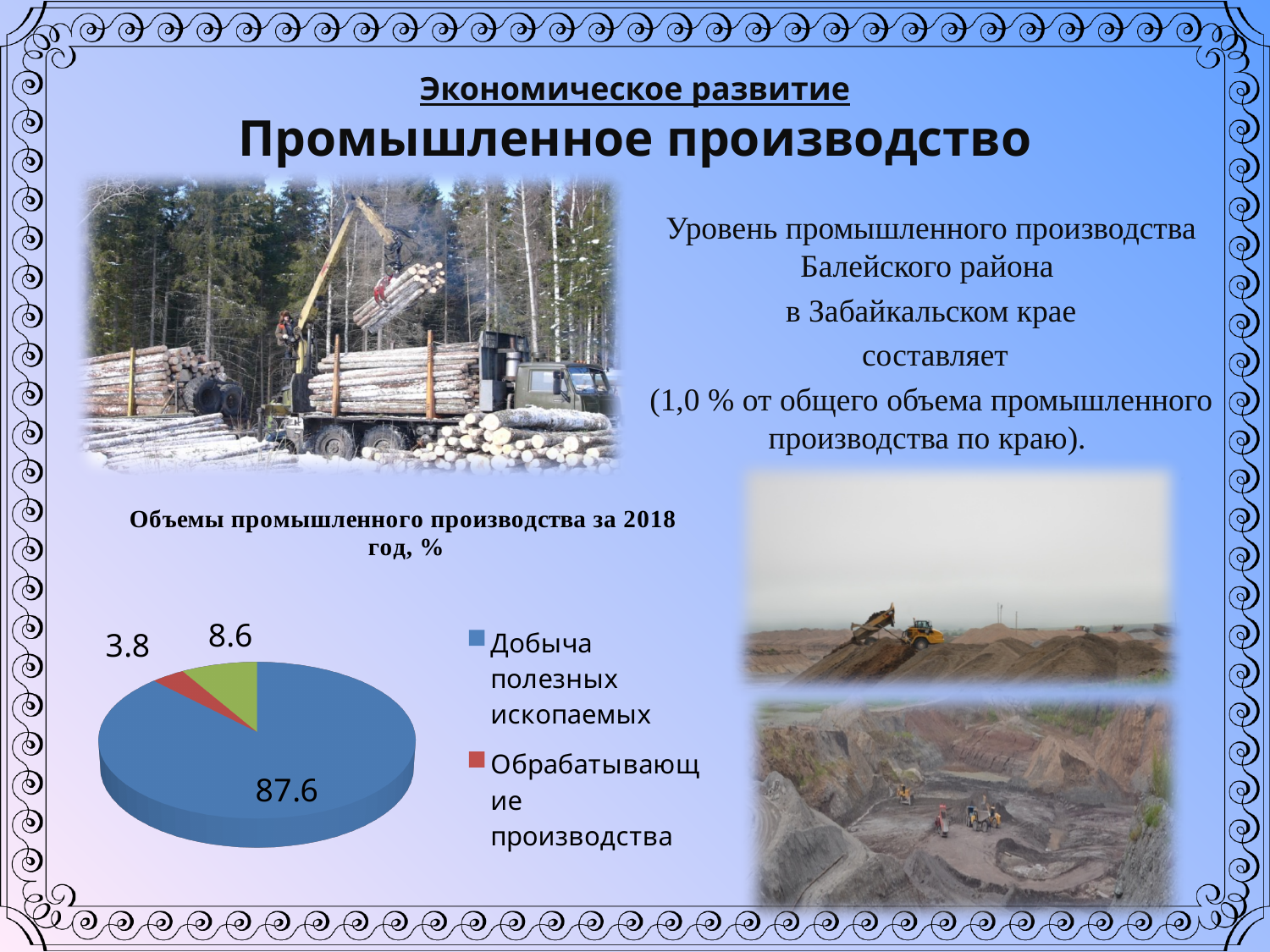
How many entries does the pie chart's legend list? 2 What kind of chart is shown on the slide? Pie chart What is the title of the pie chart? Объемы промышленного производства за 2018 год, % What colour is the slice for Добыча полезных ископаемых? Blue What is the value for Обрабатывающие производства in the pie chart? 3.8 How many slices does the pie chart have? 3 What do the three slice values in the pie chart add up to? 100 Which category has the largest slice in the pie chart? Добыча полезных ископаемых Which category has the smallest slice in the pie chart? Обрабатывающие производства What is the value for Добыча полезных ископаемых in the pie chart? 87.6 Which is larger: Добыча полезных ископаемых or Обрабатывающие производства? Добыча полезных ископаемых What is the difference between the values for Добыча полезных ископаемых and Обрабатывающие производства? 83.8